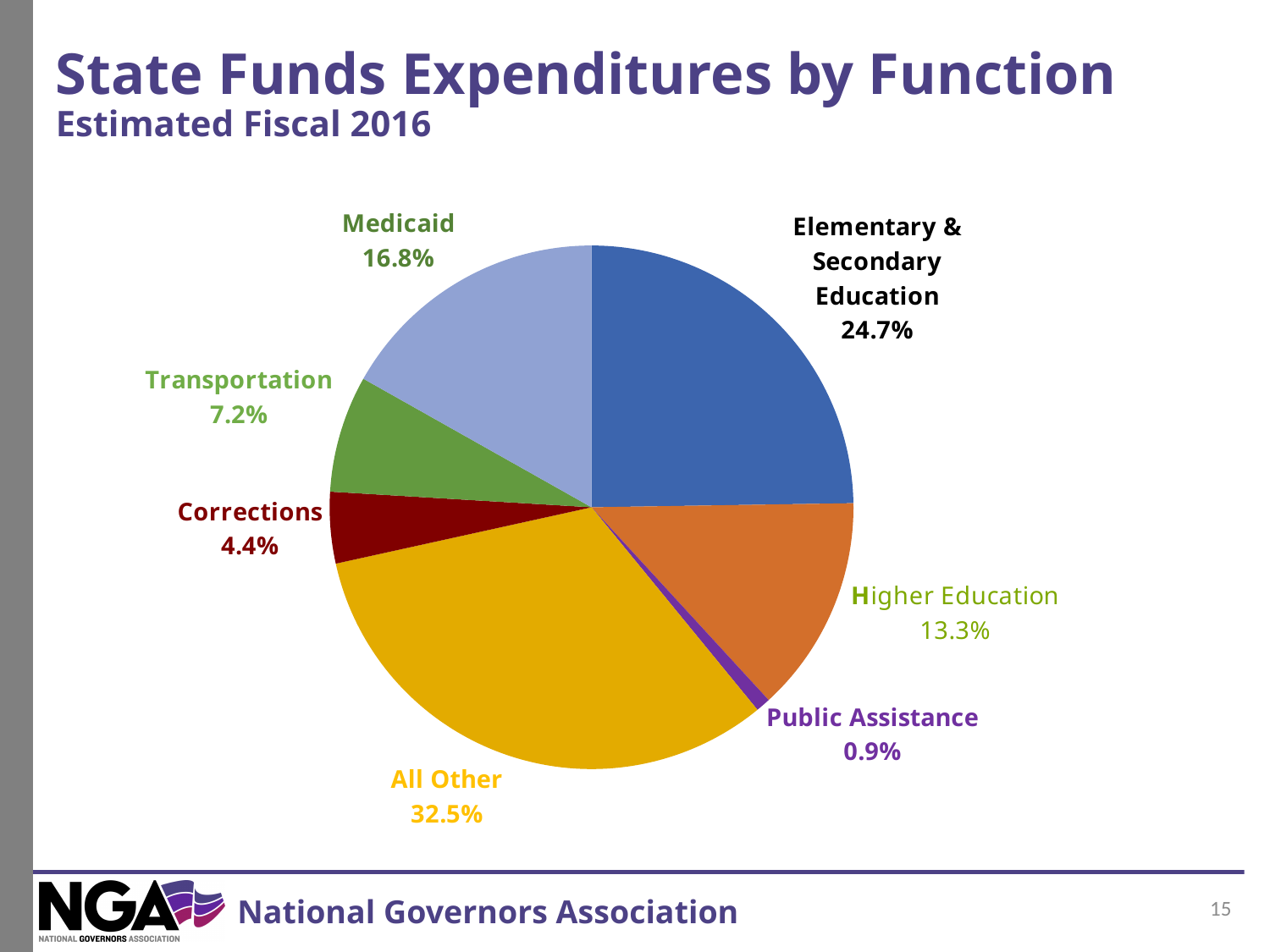
Which function has the smallest share of state funds expenditures? Public Assistance What share of state funds expenditures goes to Medicaid? 16.8% What type of chart is shown on the slide? Pie chart What fiscal year does the chart's subtitle refer to? Estimated Fiscal 2016 Which is larger, the share for Transportation or the share for Corrections? Transportation What percentage of state funds expenditures is for Elementary & Secondary Education? 24.7% What is the difference in percentage points between Medicaid and Transportation? 9.6 How many slices does the pie chart have? 7 What is the difference in percentage points between Elementary & Secondary Education and Higher Education? 11.4 What is the share for Higher Education? 13.3% What percentage is shown for Public Assistance? 0.9% Which function has the largest share of state funds expenditures? All Other